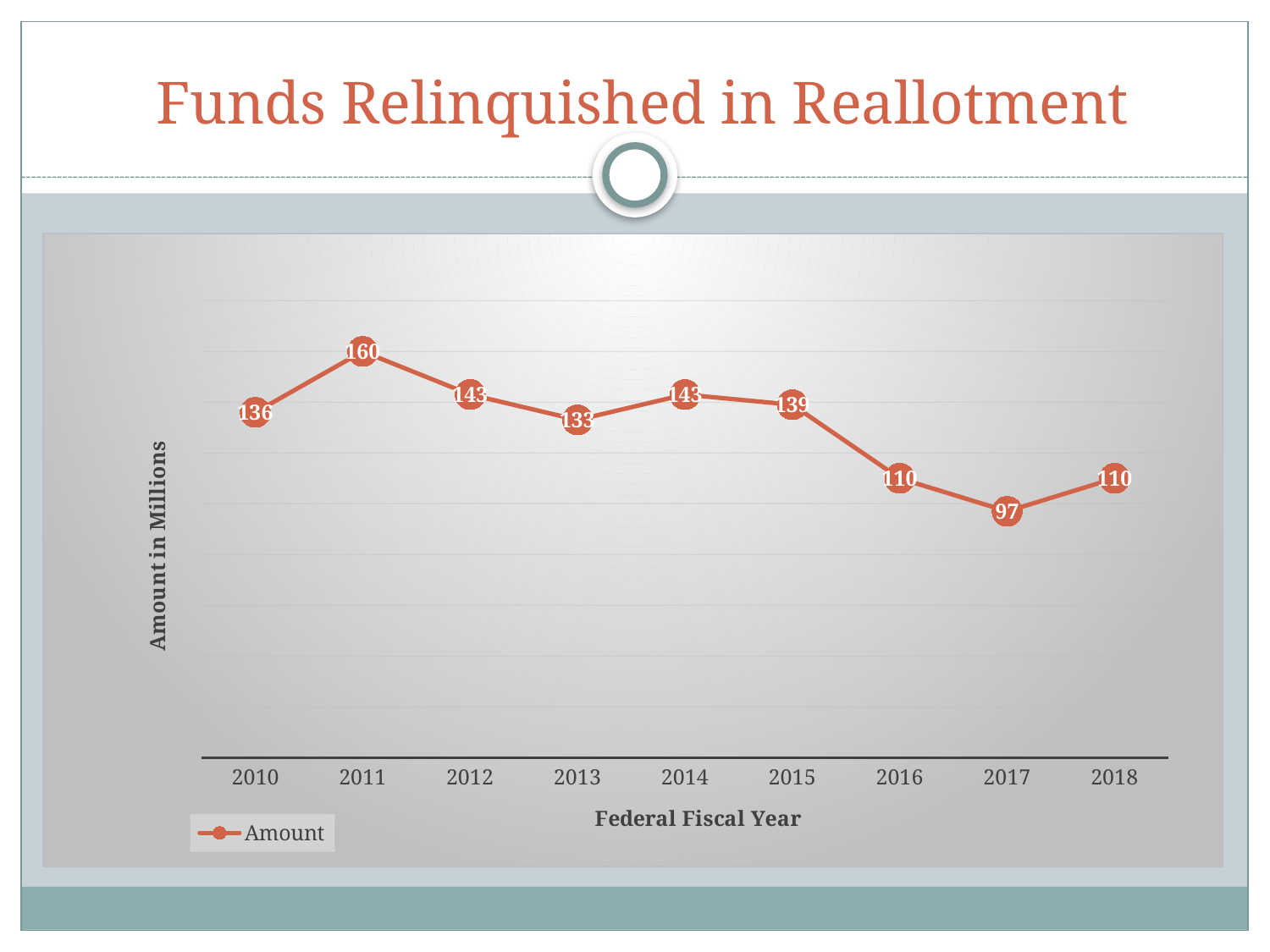
What is the value for 2017? 97 What is the difference between the values for 2011 and 2017? 63 What is the value for 2011? 160 What kind of chart is shown? line chart How many series does the legend list? 1 What is the value for 2010? 136 What is the label of the y axis? Amount in Millions Do the values rise or fall from 2015 to 2017? fall Which year has the lowest value? 2017 Which is larger, the value for 2013 or the value for 2015? 2015 Which year has the highest value? 2011 How many years are plotted on the x axis? 9